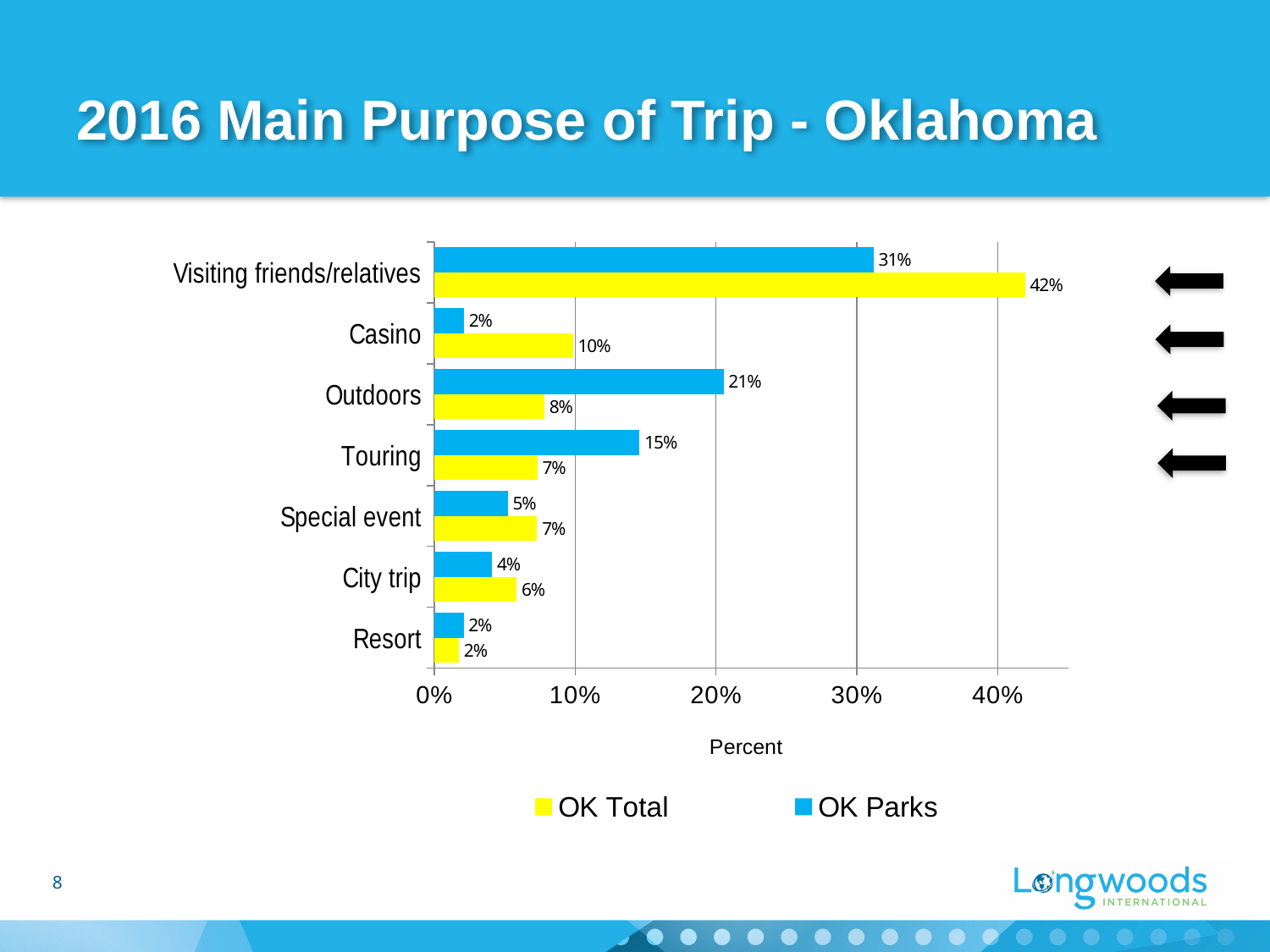
What kind of chart is shown on the slide? Bar chart Is the OK Total value for Visiting friends/relatives greater or less than 40%? greater Which category has the highest OK Total value? Visiting friends/relatives Which is larger for Touring, the OK Parks value or the OK Total value? OK Parks How many series does the legend list? 2 Which colour represents the OK Parks series? Blue How many trip purpose categories are shown on the chart? 7 Which category has the lowest OK Total value? Resort What is the OK Total value for Casino? 10% What is the OK Parks value for Visiting friends/relatives? 31% What is the difference between the OK Total and OK Parks values for Visiting friends/relatives? 11% What is the OK Parks value for Outdoors? 21%